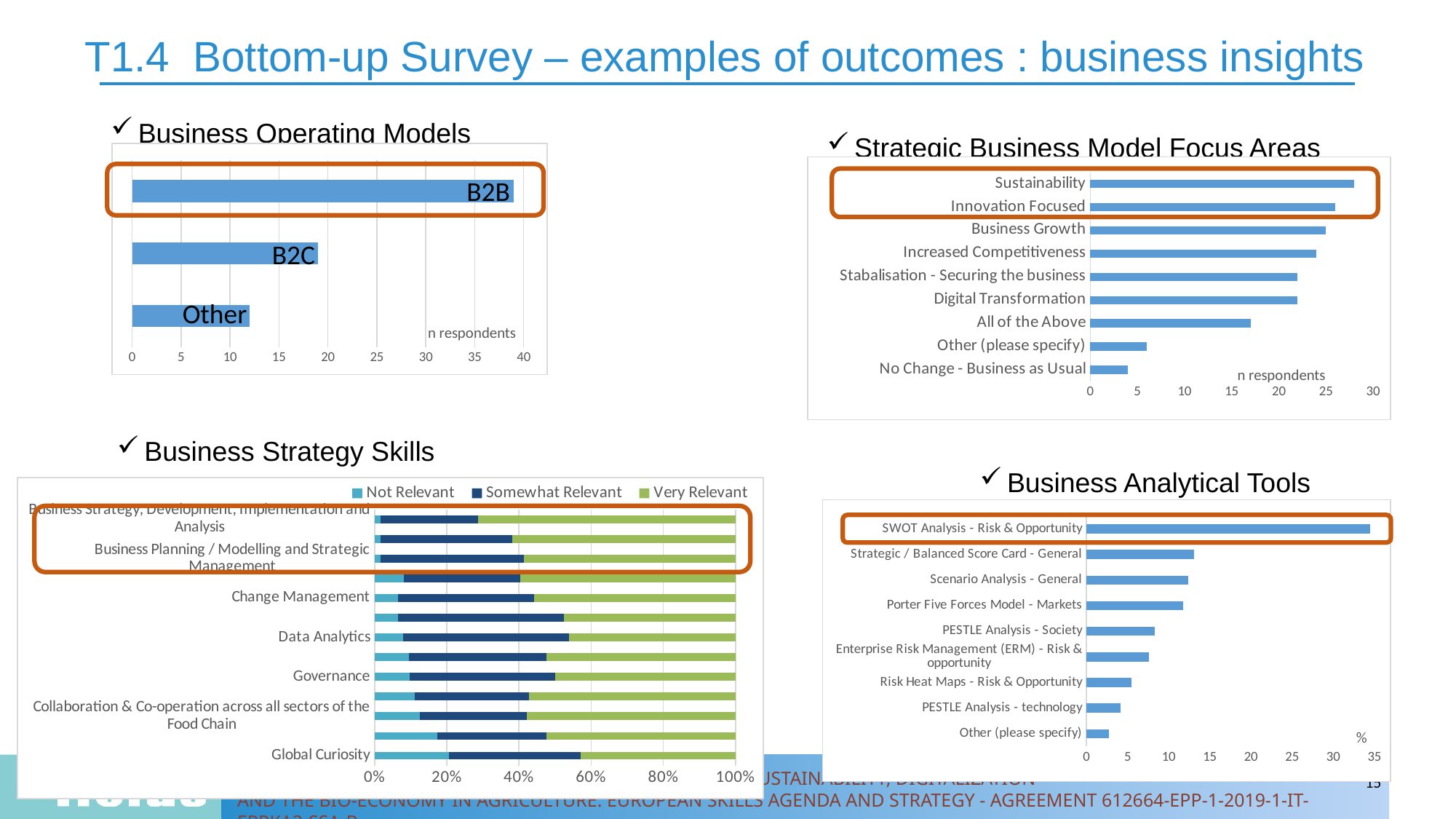
In the Strategic Business Model Focus Areas chart, how many focus areas are listed? 9 In the Business Operating Models chart, which category has the highest number of respondents? B2B In the Business Operating Models chart, is the value for B2C greater or less than 25? less In the Business Strategy Skills chart, how many series does the legend list? 3 In the Strategic Business Model Focus Areas chart, is the value for All of the Above greater or less than 20? less In the Business Operating Models chart, which category has the lowest number of respondents? Other In the Strategic Business Model Focus Areas chart, which focus area has the most respondents? Sustainability What kind of chart is the Business Analytical Tools chart? Bar chart In the Business Analytical Tools chart, which is larger: PESTLE Analysis - Society or Risk Heat Maps - Risk & Opportunity? PESTLE Analysis - Society In the Strategic Business Model Focus Areas chart, which focus area has the fewest respondents? No Change - Business as Usual In the Business Analytical Tools chart, which tool has the highest percentage? SWOT Analysis - Risk & Opportunity In the Business Operating Models chart, is the value for B2B greater or less than 35? greater